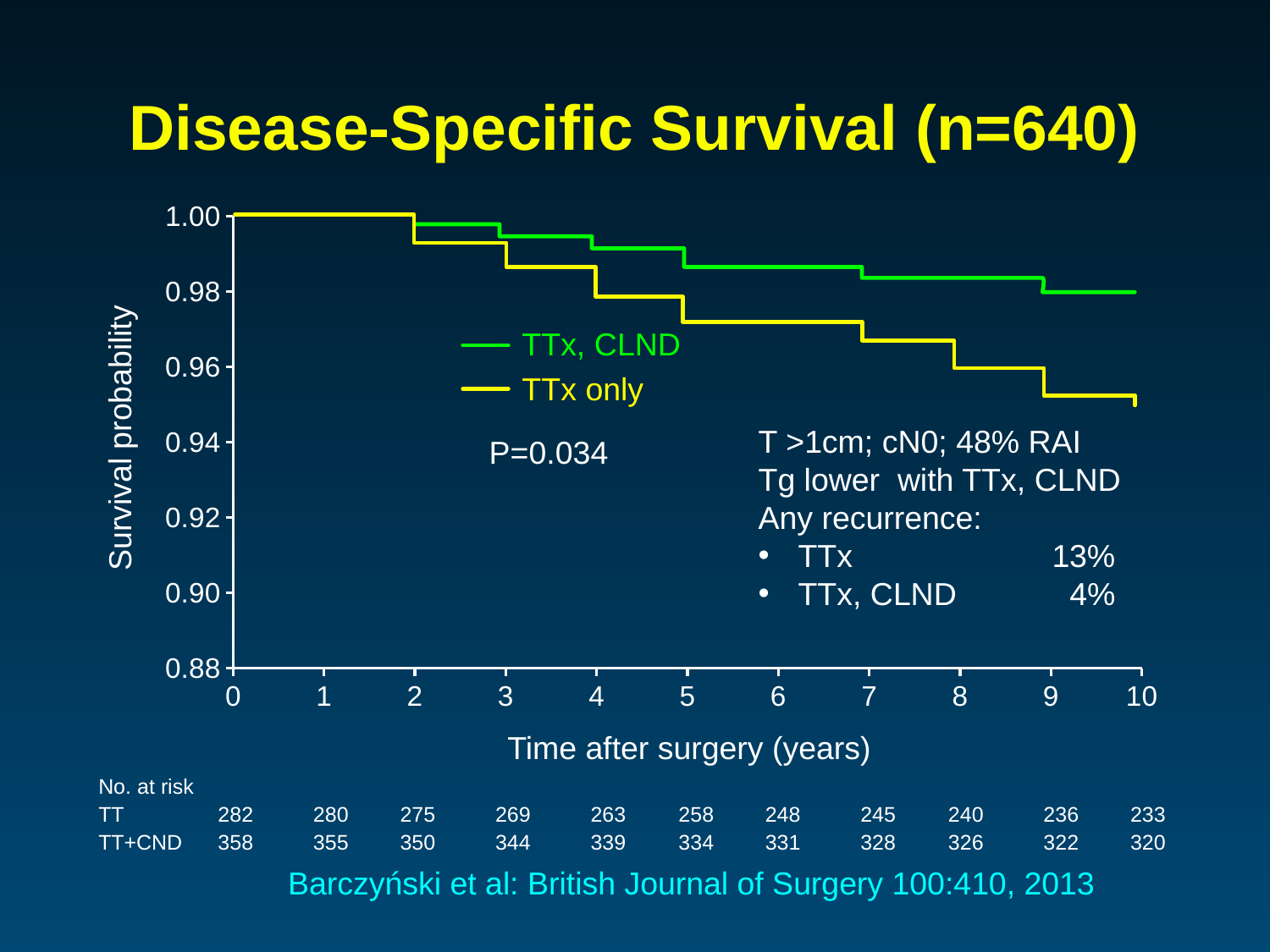
Is the survival probability for TTx only at 10 years greater or less than 0.96? less In the No. at risk table, how many TT+CND patients are at risk at year 10? 320 In the No. at risk table, how many TT patients are at risk at year 0? 282 Is the survival probability for TTx, CLND at 10 years greater or less than 0.96? greater In the No. at risk table, what is the difference between the TT+CND and TT numbers at risk at year 0? 76 What are the two series named in the legend? TTx, CLND and TTx only How many time points (years) are labelled on the x axis? 11 Do the survival probability curves rise or fall as time after surgery increases? fall How many series does the legend list? 2 What is the title of the chart? Disease-Specific Survival (n=640) What kind of chart is shown on the slide? line chart At 10 years after surgery, which series has the higher survival probability, TTx, CLND or TTx only? TTx, CLND